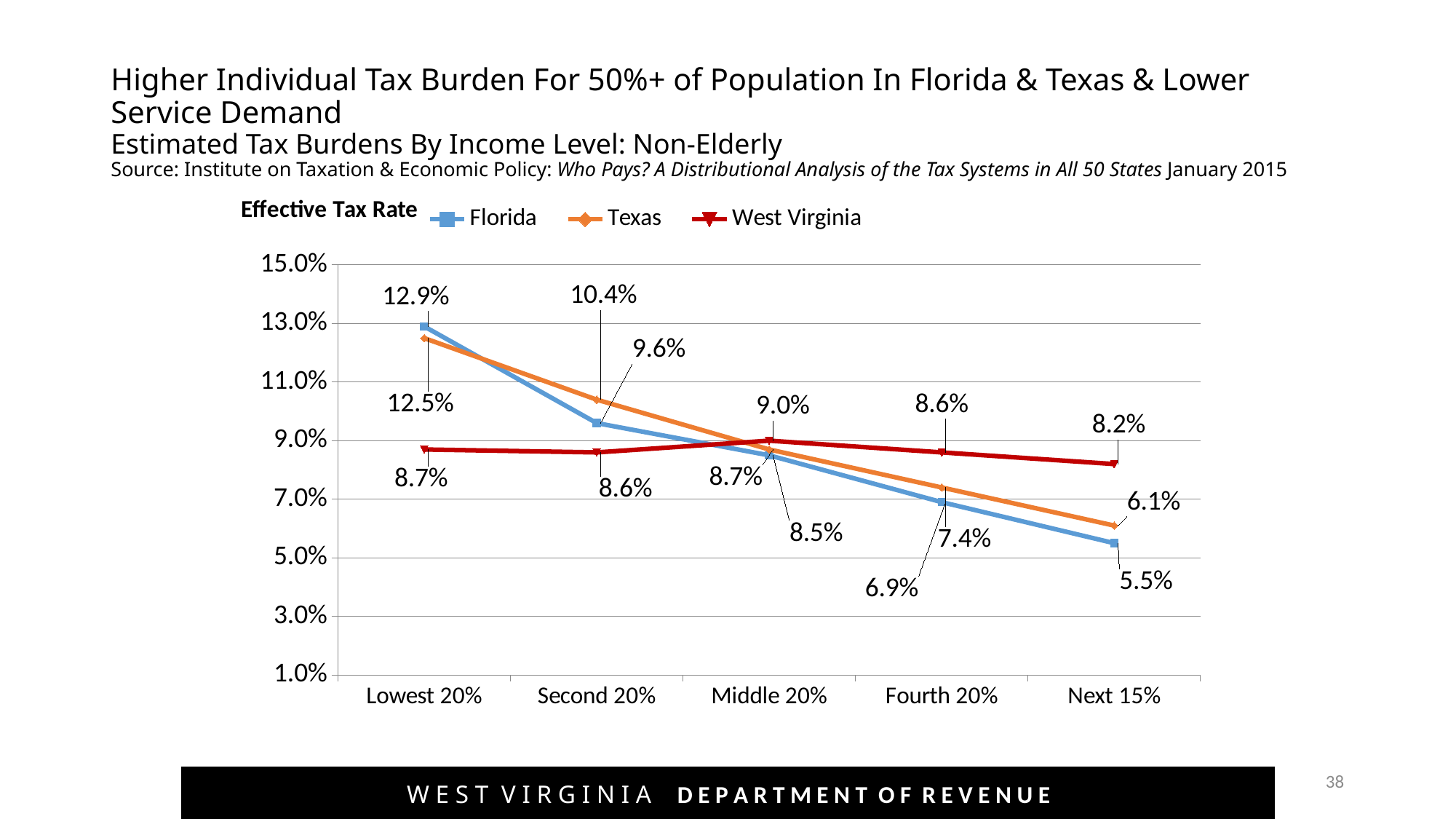
How many income levels are shown on the x axis? 5 Does Florida's effective tax rate rise or fall from the Lowest 20% to the Next 15% income level? Fall What is the effective tax rate for Florida at the Next 15% income level? 5.5% What is the effective tax rate for West Virginia at the Next 15% income level? 8.2% What is the effective tax rate for Texas at the Second 20% income level? 10.4% At which income level is West Virginia's effective tax rate highest? Middle 20% What is the effective tax rate for Florida at the Lowest 20% income level? 12.9% Which state has the higher effective tax rate at the Fourth 20% income level, Texas or Florida? Texas How many series does the legend list? 3 At which income level is Florida's effective tax rate lowest? Next 15% What kind of chart is shown on the slide? Line chart What is the difference between Florida's and West Virginia's effective tax rates at the Lowest 20% income level? 4.2%